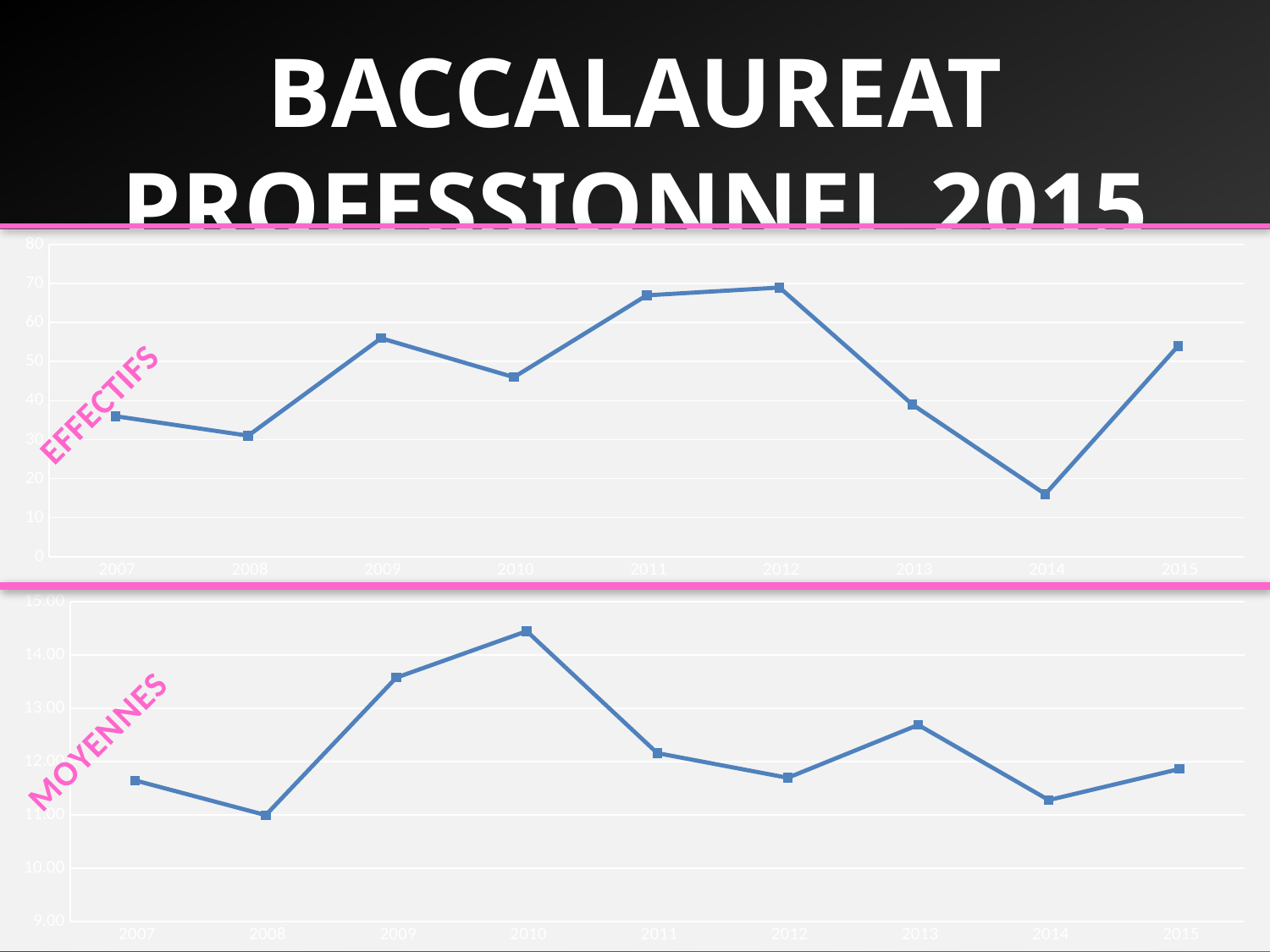
In the MOYENNES chart, which year has the highest value? 2010 In the EFFECTIFS chart, which is larger, the value for 2011 or the value for 2014? 2011 What kind of chart is the top chart labelled EFFECTIFS? line chart In the EFFECTIFS chart, is the value for 2012 greater or less than 60? greater In the MOYENNES chart, which year has the lowest value? 2008 In the EFFECTIFS chart, which year has the lowest value? 2014 How many years are plotted on the x axis of the EFFECTIFS chart? 9 In the MOYENNES chart, is the value for 2010 greater or less than 14.00? greater In the MOYENNES chart, do the values rise or fall from 2008 to 2010? rise In the EFFECTIFS chart, is the value for 2014 greater or less than 20? less In the MOYENNES chart, which is larger, the value for 2009 or the value for 2012? 2009 In the EFFECTIFS chart, do the values rise or fall from 2012 to 2014? fall